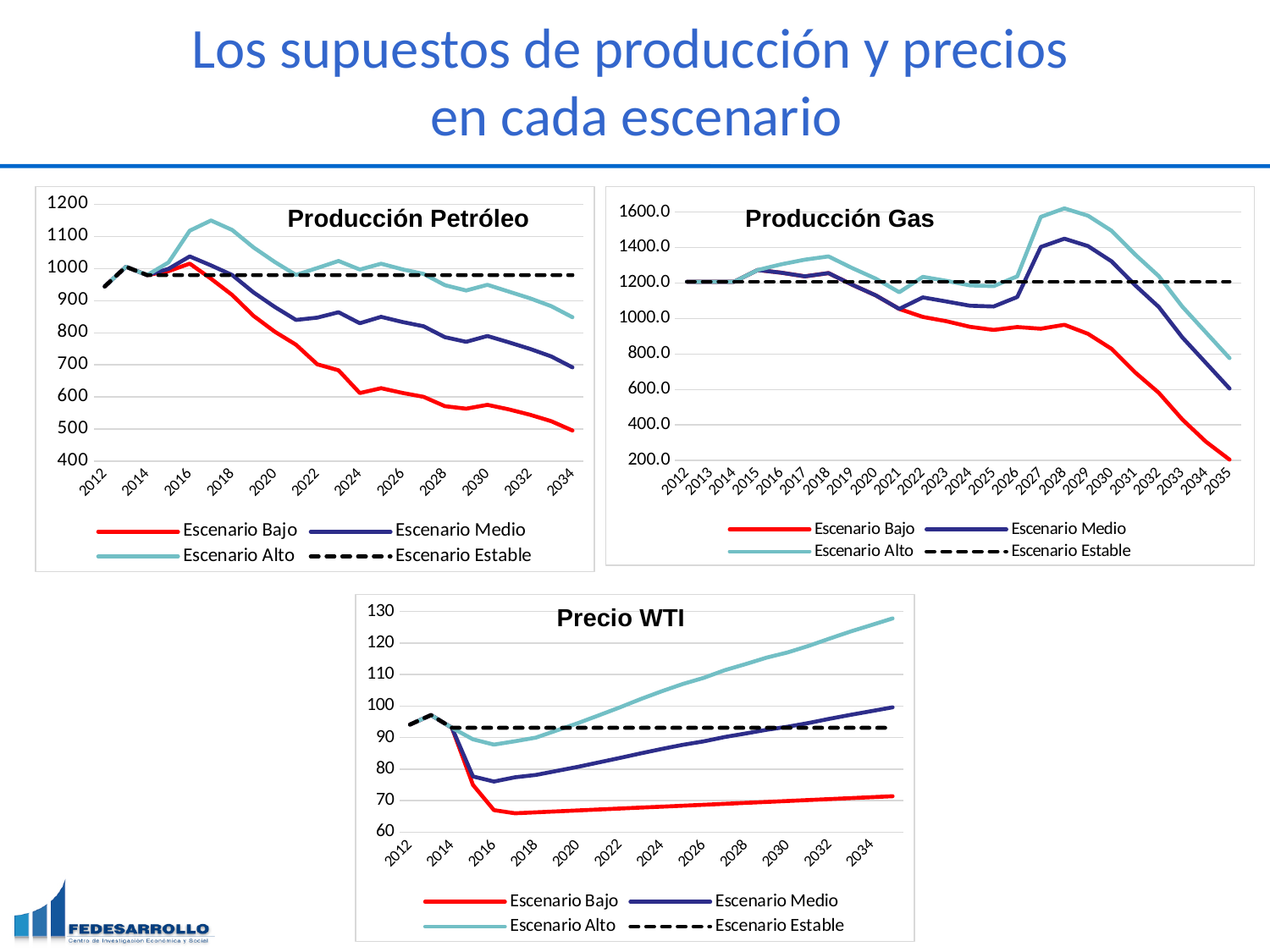
In the Producción Gas chart, which series is highest in 2028? Escenario Alto In the Precio WTI chart, which is larger in 2035, Escenario Medio or Escenario Bajo? Escenario Medio In the Producción Petróleo chart, is the value for Escenario Bajo in 2030 greater or less than 600? less In the Precio WTI chart, is the value for Escenario Alto in 2035 greater or less than 120? greater In the Producción Petróleo chart, does the Escenario Bajo series rise or fall between 2016 and 2034? fall In the Precio WTI chart, which series is drawn as a dashed black line? Escenario Estable In the Producción Gas chart, is the value for Escenario Bajo in 2035 greater or less than 400? less What kind of chart is the Producción Petróleo chart? line chart How many series does the legend of the Producción Gas chart list? 4